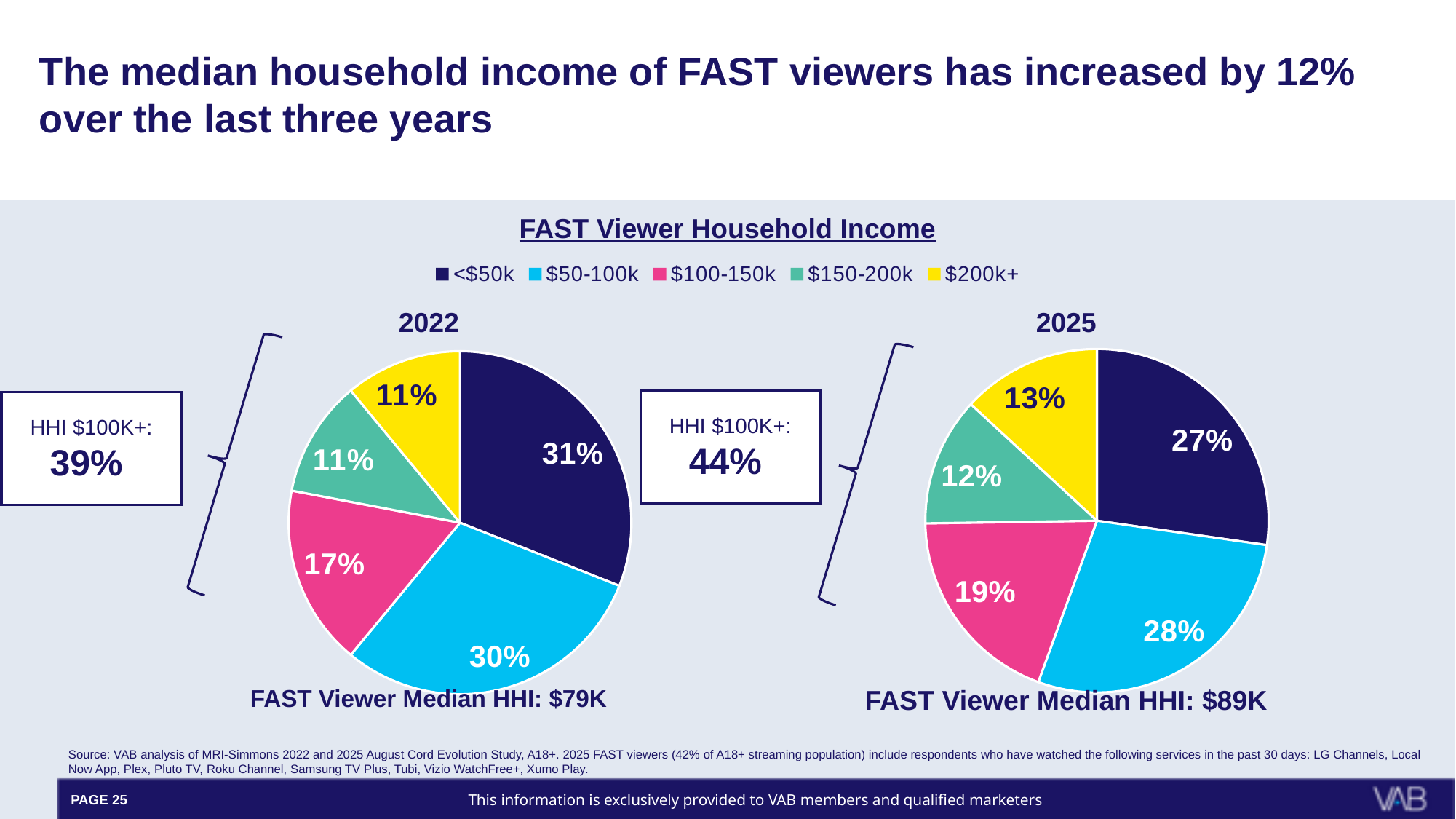
Which is larger: the <$50k share in the 2022 pie chart or the <$50k share in the 2025 pie chart? 2022 In the 2022 pie chart, which income bracket has the largest share? <$50k What colour represents the $200k+ bracket in the pie charts? Yellow In the 2025 pie chart, what share of FAST viewers have a household income of $50-100k? 28% In the 2025 pie chart, what share of FAST viewers have a household income of $200k+? 13% What type of chart is used to show FAST Viewer Household Income? Pie chart In the 2025 pie chart, which income bracket has the largest share? $50-100k What is the FAST Viewer Median HHI shown under the 2025 pie chart? $89K In the 2025 pie chart, which income bracket has the smallest share? $150-200k In the 2022 pie chart, what share of FAST viewers have a household income under $50k? 31% What is the difference between the $100-150k share in the 2025 pie chart and the $100-150k share in the 2022 pie chart? 2% How many income brackets does the legend list? 5